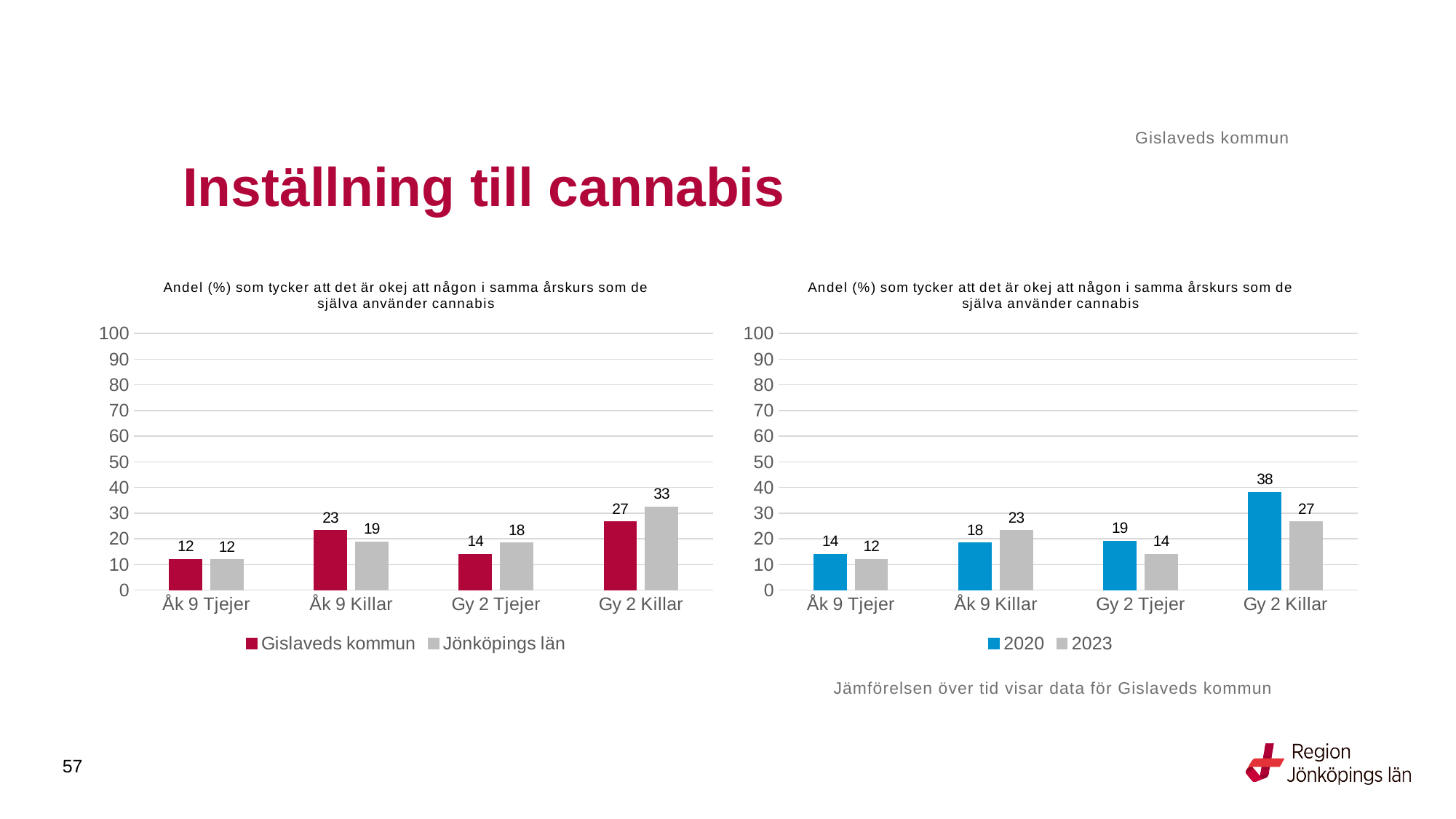
In the right chart, which category has the lowest value for 2023? Åk 9 Tjejer How many series does the legend of the right chart list? 2 In the right chart, what is the value for 2023 for Gy 2 Tjejer? 14 What kind of chart is the left chart? Bar chart In the left chart, what is the difference between Jönköpings län and Gislaveds kommun for Gy 2 Killar? 6 How many categories are shown on the x axis of the left chart? 4 In the right chart, which is larger for Åk 9 Killar: 2020 or 2023? 2023 In the left chart, what is the value for Jönköpings län for Åk 9 Killar? 19 In the right chart, what is the difference between 2020 and 2023 for Gy 2 Killar? 11 In the left chart, what is the value for Gislaveds kommun for Gy 2 Killar? 27 In the right chart, what is the value for 2020 for Gy 2 Killar? 38 In the left chart, which category has the highest value for Jönköpings län? Gy 2 Killar